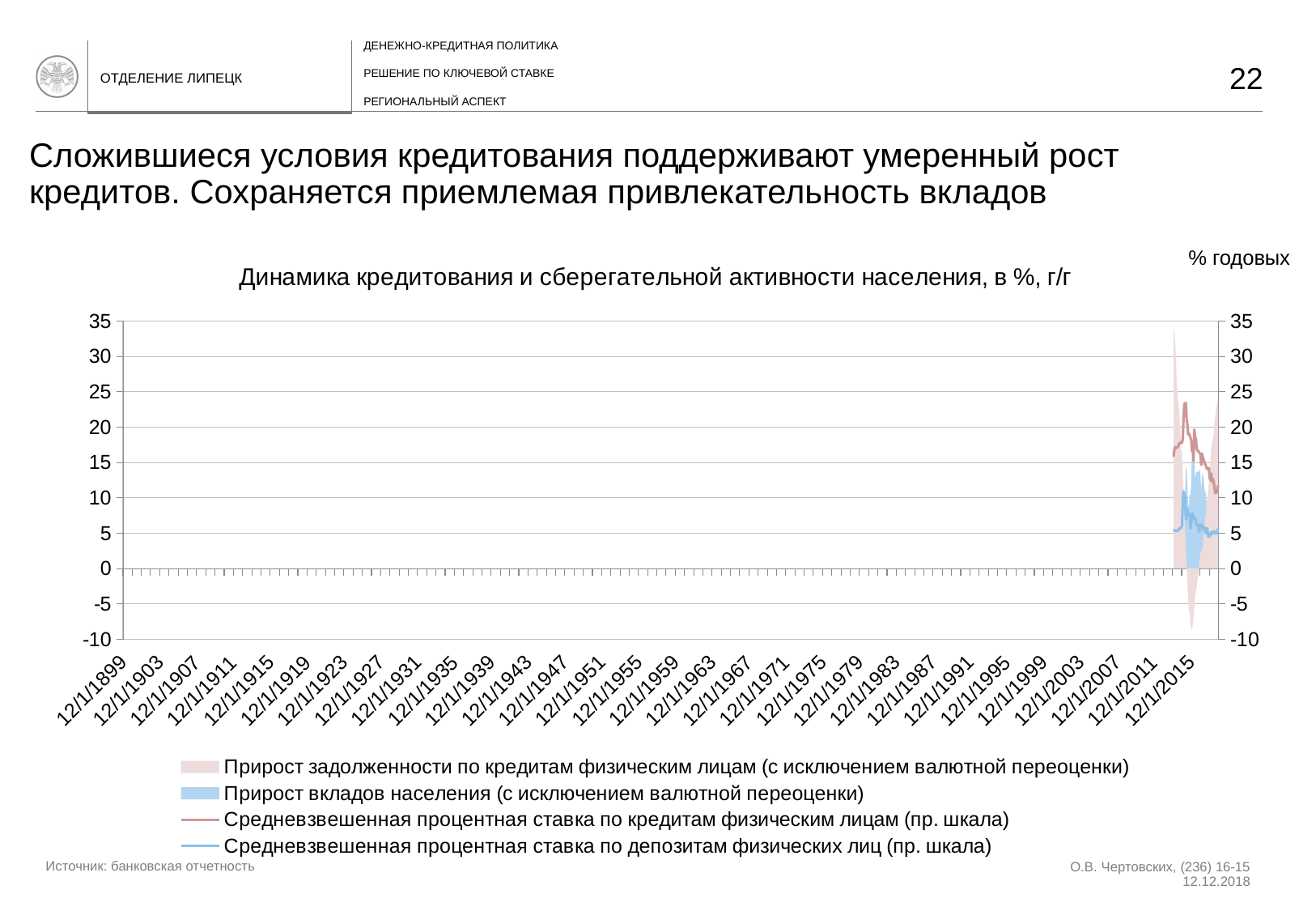
Which series in the legend is drawn as a light blue filled area? Прирост вкладов населения (с исключением валютной переоценки) Is the peak value of the 'Средневзвешенная процентная ставка по кредитам физическим лицам' line greater or less than 20? greater Is the lowest value of the 'Прирост задолженности по кредитам физическим лицам' area greater or less than 0? less How many series does the chart legend list? 4 After reaching its peak, does the 'Средневзвешенная процентная ставка по кредитам физическим лицам' line rise or fall toward the right end of the chart? fall What label is shown above the right vertical axis? % годовых Is the final value of the 'Средневзвешенная процентная ставка по депозитам физических лиц' line greater or less than 10? less What kind of chart is shown on the slide? Combined area and line chart What is the title of the chart? Динамика кредитования и сберегательной активности населения, в %, г/г At the right end of the chart, which line is higher: the loan rate line or the deposit rate line? The loan rate line (Средневзвешенная процентная ставка по кредитам физическим лицам) How many date labels are shown on the x axis? 30